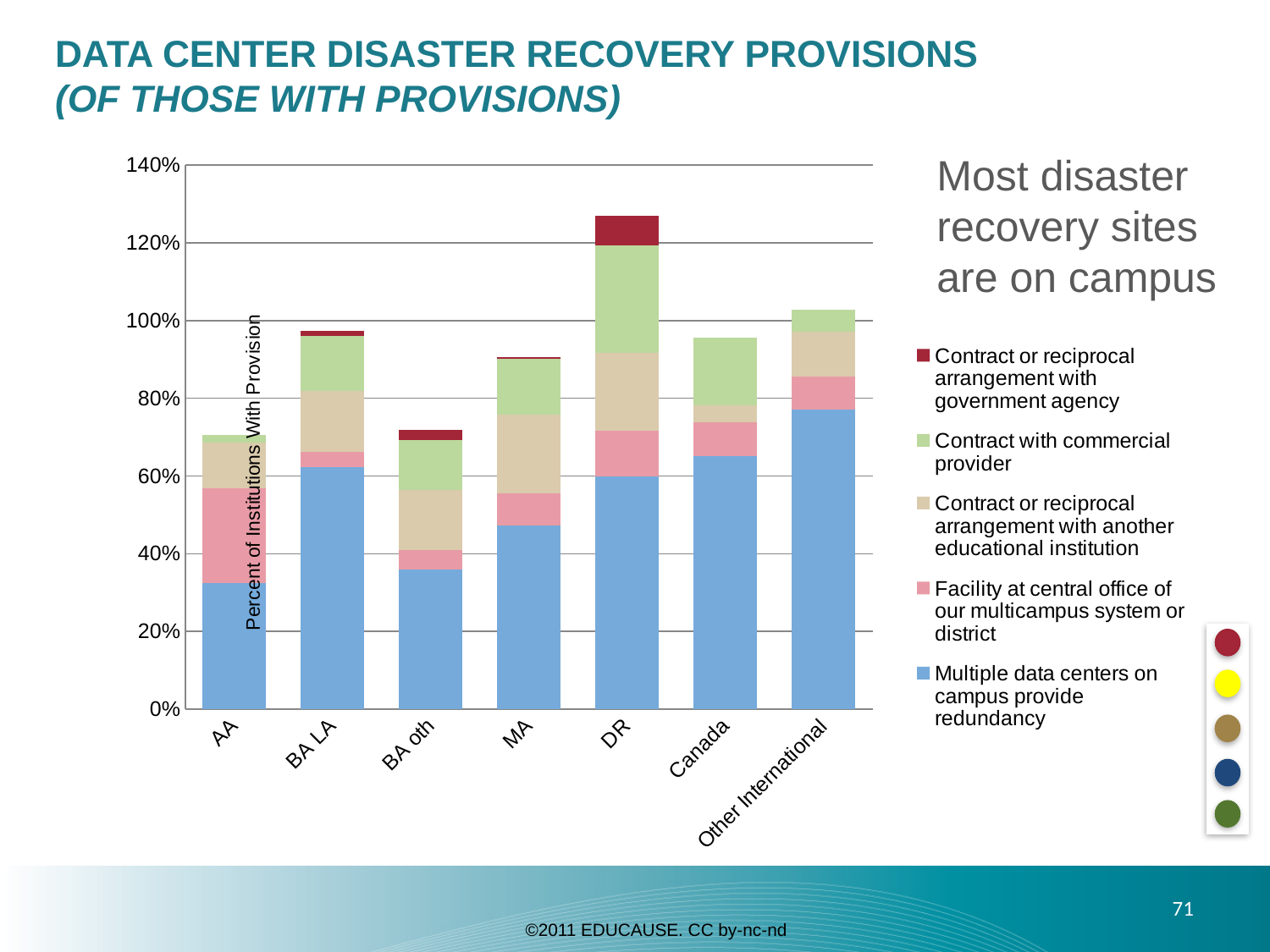
Which category has the larger 'Multiple data centers on campus provide redundancy' segment, BA LA or Other International? Other International Is the 'Multiple data centers on campus provide redundancy' value for AA greater or less than 40%? less Is the total stacked value for Canada greater or less than 100%? less Is the total stacked value for AA greater or less than 80%? less How many categories are shown along the x axis of the chart? 7 Which category has the tallest stacked bar overall? DR How many series does the chart's legend list? 5 What kind of chart is shown on the slide? Stacked bar chart What is the label on the chart's vertical axis? Percent of Institutions With Provision Which has the larger total stacked bar, DR or Canada? DR